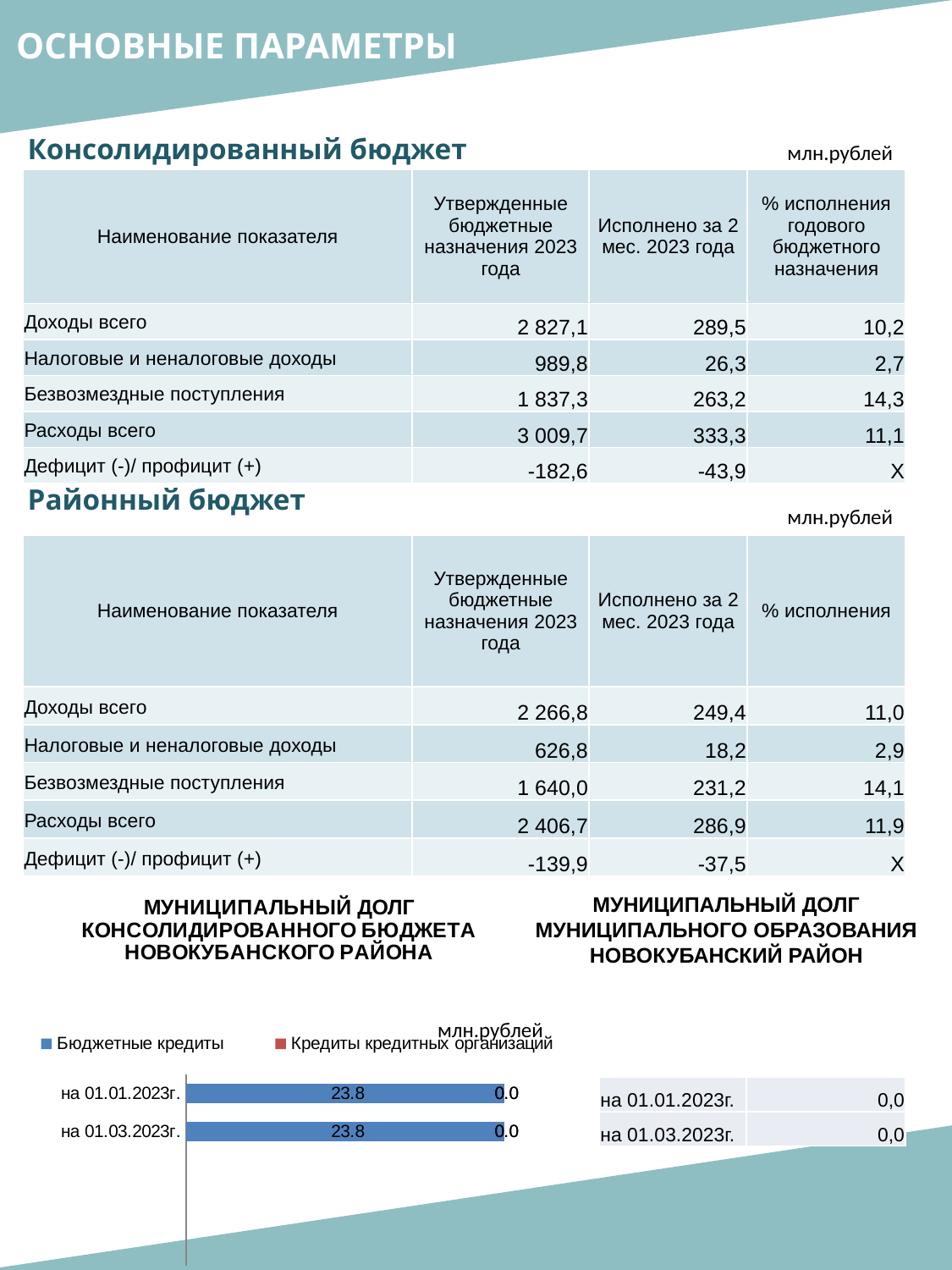
In the bar chart at the bottom left, what is the value of 'Кредиты кредитных организаций' for 'на 01.01.2023г.'? 0.0 What kind of chart is shown under the heading 'МУНИЦИПАЛЬНЫЙ ДОЛГ КОНСОЛИДИРОВАННОГО БЮДЖЕТА НОВОКУБАНСКОГО РАЙОНА'? Bar chart How many categories (dates) are shown in the bar chart at the bottom left? 2 In the bar chart at the bottom left, what is the difference between 'Бюджетные кредиты' and 'Кредиты кредитных организаций' for 'на 01.01.2023г.'? 23.8 In the bar chart at the bottom left, which colour represents 'Бюджетные кредиты'? Blue In the bar chart at the bottom left, does the value of 'Бюджетные кредиты' rise, fall or stay the same from 'на 01.01.2023г.' to 'на 01.03.2023г.'? Stays the same How many series does the legend of the bar chart at the bottom left list? 2 In the bar chart at the bottom left, what is the value of 'Бюджетные кредиты' for 'на 01.01.2023г.'? 23.8 In the bar chart at the bottom left, what is the value of 'Бюджетные кредиты' for 'на 01.03.2023г.'? 23.8 In the bar chart at the bottom left, which series is larger for 'на 01.03.2023г.': 'Бюджетные кредиты' or 'Кредиты кредитных организаций'? Бюджетные кредиты In the bar chart at the bottom left, what is the value of 'Кредиты кредитных организаций' for 'на 01.03.2023г.'? 0.0 What unit is stated above the legend of the bar chart at the bottom left? млн.рублей